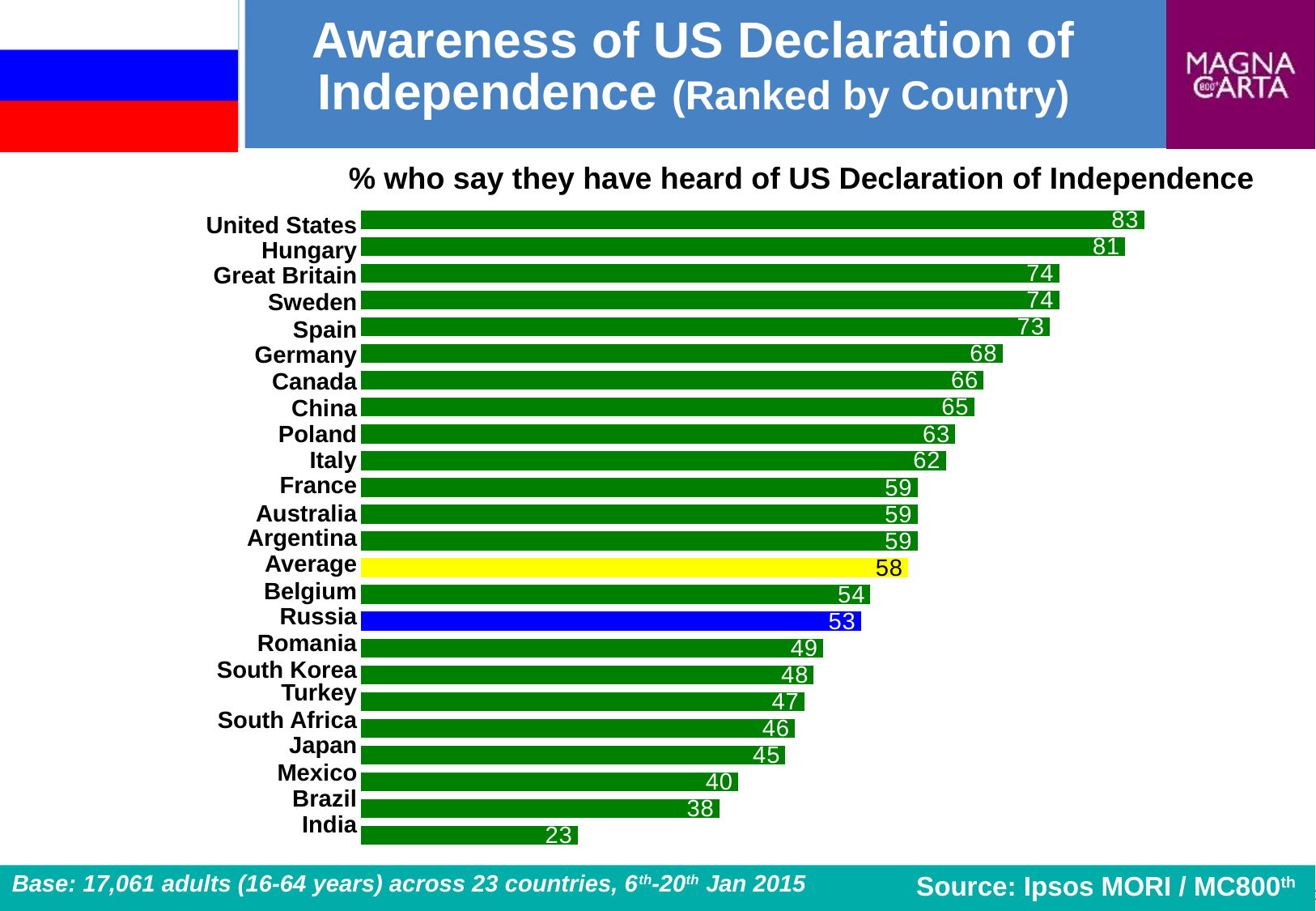
How many bars are shown on the chart, including the Average bar? 24 What percentage of people in Russia say they have heard of the US Declaration of Independence? 53 Which bar on the chart is coloured blue? Russia How many points higher is Hungary than Russia? 28 Which country has the lowest value on the chart? India What type of chart is shown on the slide? Bar chart What is the value shown for Germany? 68 Which country has the highest awareness of the US Declaration of Independence? United States Which has a higher value, Belgium or Romania? Belgium Which has a higher value, Canada or Poland? Canada What is the Average value shown on the chart? 58 What is the difference between the values for the United States and India? 60